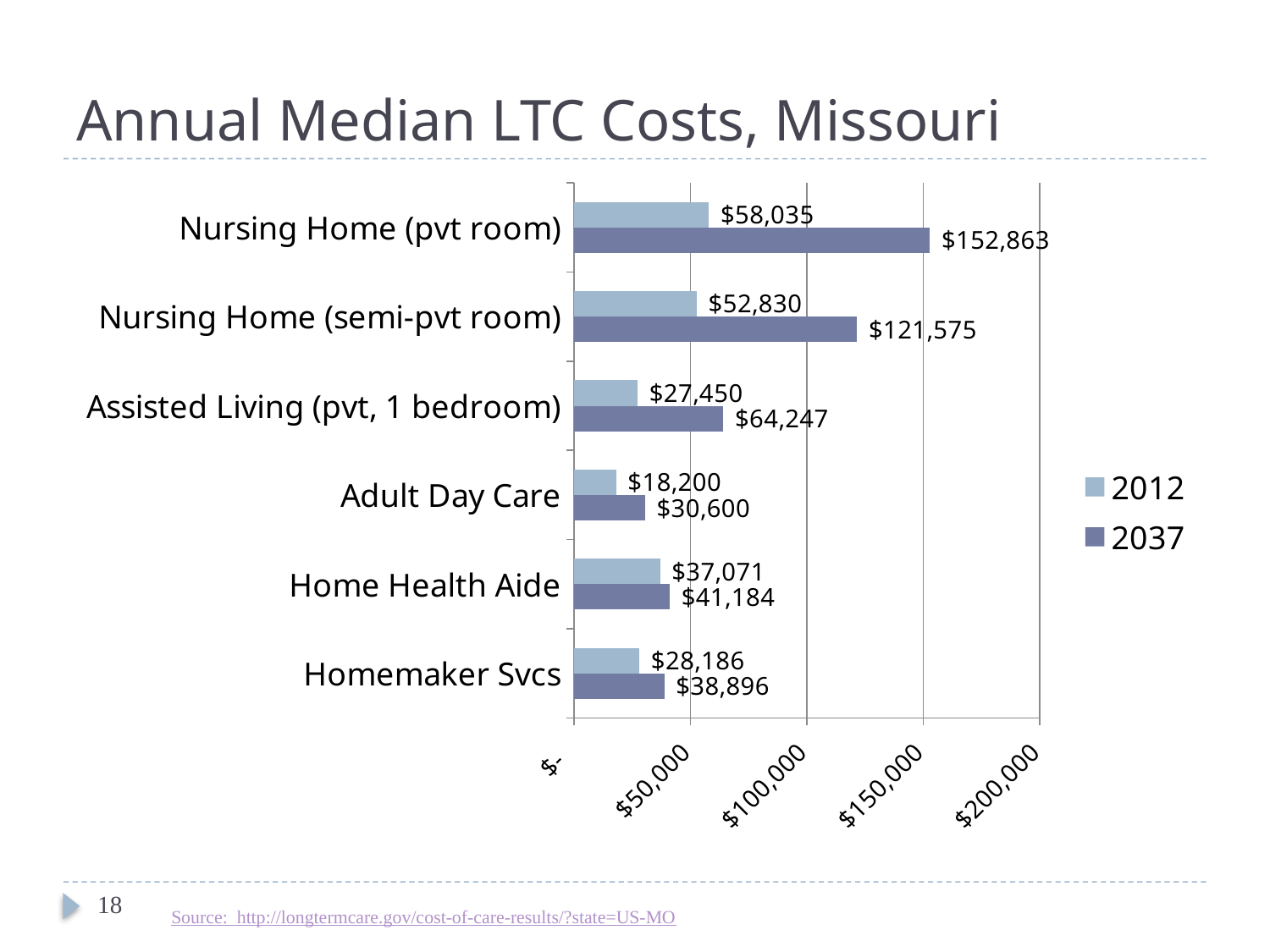
What is the difference between the 2037 and 2012 values for Nursing Home (semi-pvt room)? $68,745 What is the title of the chart? Annual Median LTC Costs, Missouri What is the 2037 value for Home Health Aide? $41,184 What is the 2012 value for Adult Day Care? $18,200 What is the 2037 value for Nursing Home (pvt room)? $152,863 Which category has the highest 2037 value? Nursing Home (pvt room) Is the 2037 value for Assisted Living (pvt, 1 bedroom) greater or less than $50,000? greater How many series does the legend list? 2 How many categories are shown on the chart? 6 Which is larger, the 2012 value for Home Health Aide or the 2012 value for Homemaker Svcs? Home Health Aide Which category has the lowest 2012 value? Adult Day Care What kind of chart is shown on the slide? bar chart